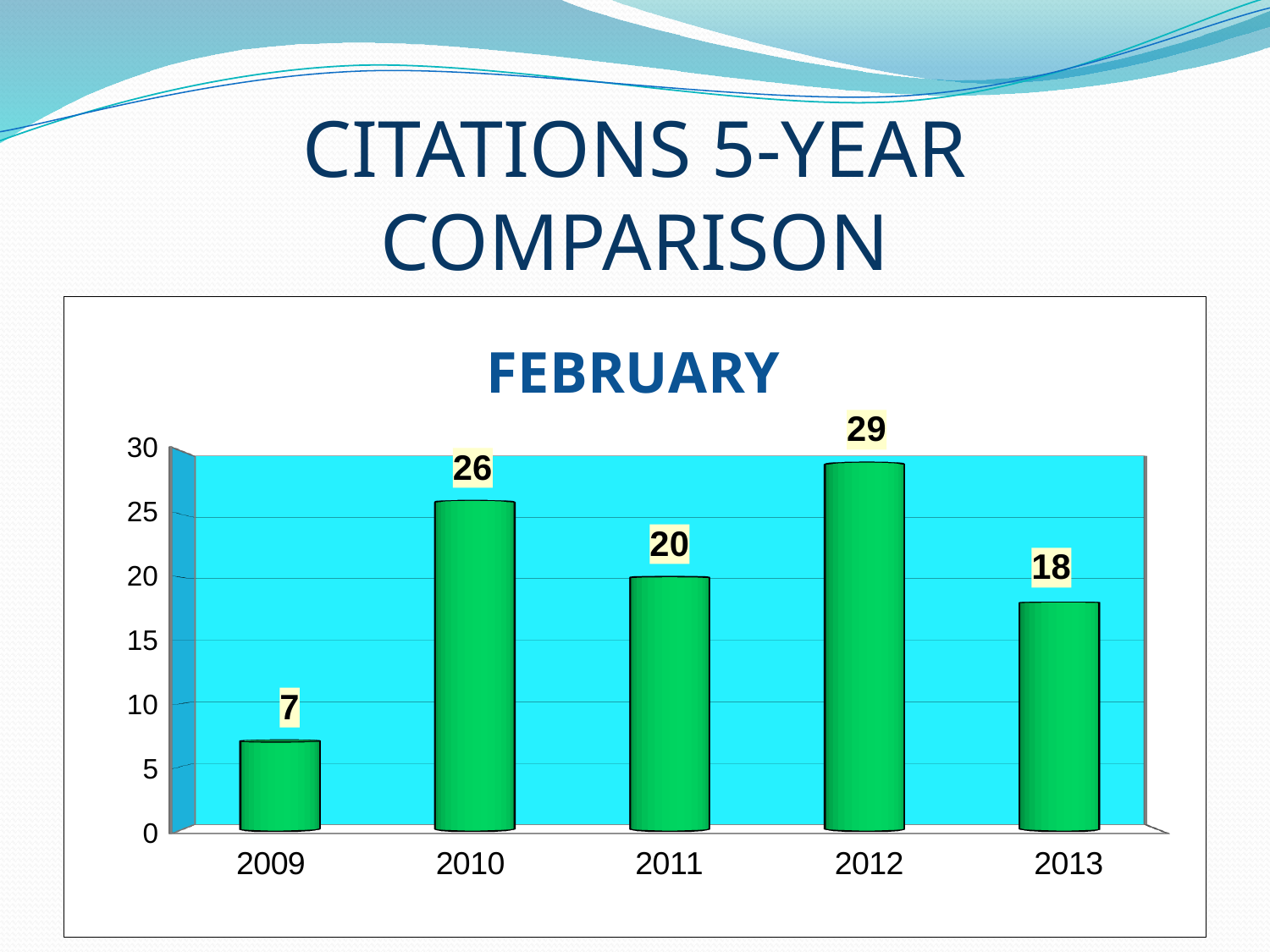
Is the value for 2010 greater or less than 25? greater What is the title of the chart? FEBRUARY Which year has the lowest value? 2009 How many years are shown on the x axis? 5 What is the value for 2012? 29 Which is larger, the value for 2011 or the value for 2013? 2011 What is the difference between the values for 2012 and 2009? 22 What is the value for 2013? 18 What kind of chart is shown? bar chart What is the difference between the values for 2010 and 2011? 6 What is the value for 2009? 7 Which year has the highest value? 2012